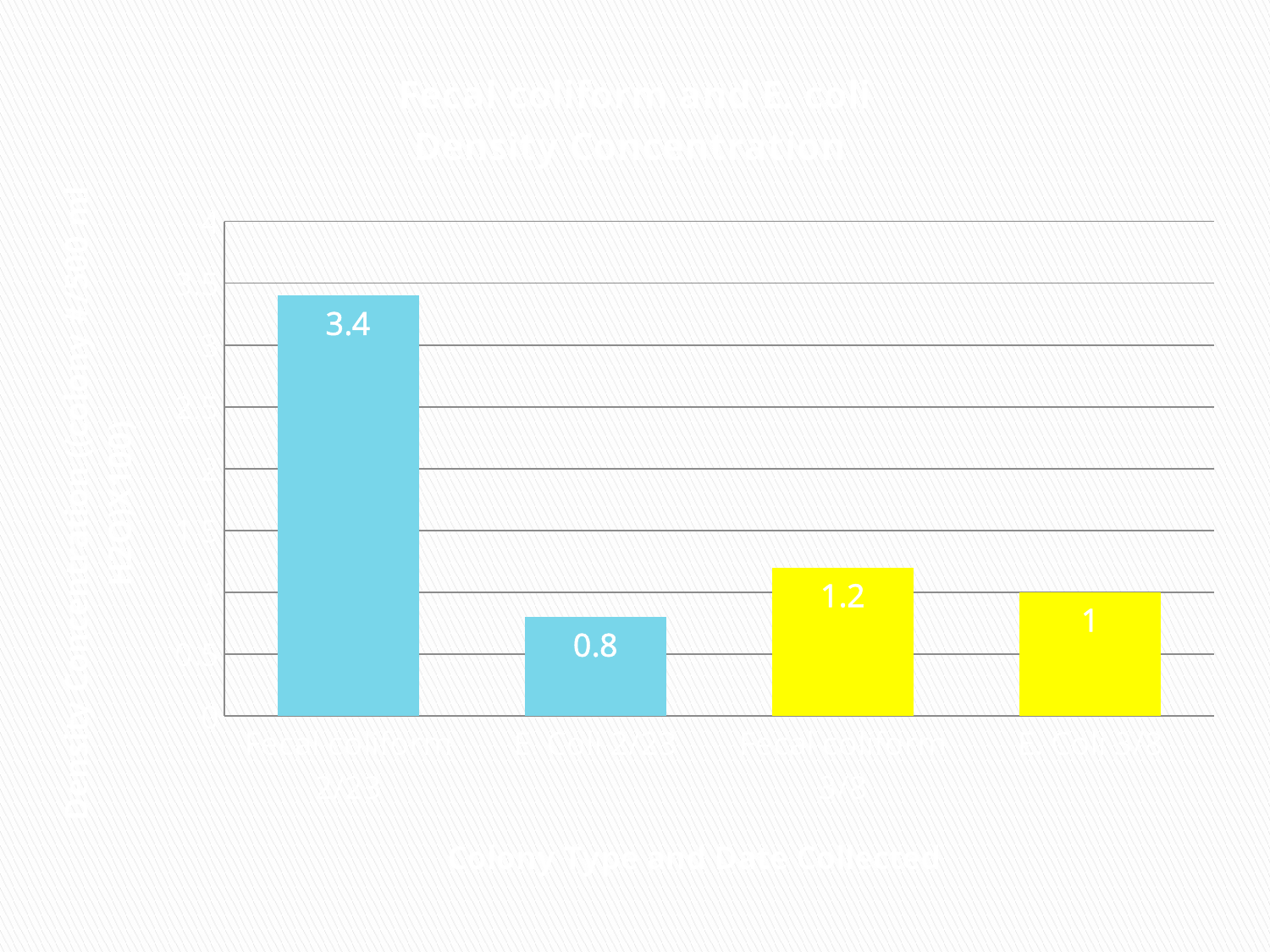
Which bar has the lowest value? the second bar from the left (0.8) Which bar has the highest value? the leftmost bar (3.4) What is the value shown on the rightmost (fourth) bar? 1 What is the value shown on the third bar from the left? 1.2 What kind of chart is shown on the slide? bar chart Which is larger, the value of the third bar or the value of the fourth bar? the third bar (1.2) What is the difference between the first bar's value and the second bar's value? 2.6 What is the difference between the third bar's value and the fourth bar's value? 0.2 What is the value shown on the second bar from the left? 0.8 What is the value shown on the leftmost (first) bar? 3.4 How many bars are plotted in the chart? 4 How many of the bars are coloured yellow? 2